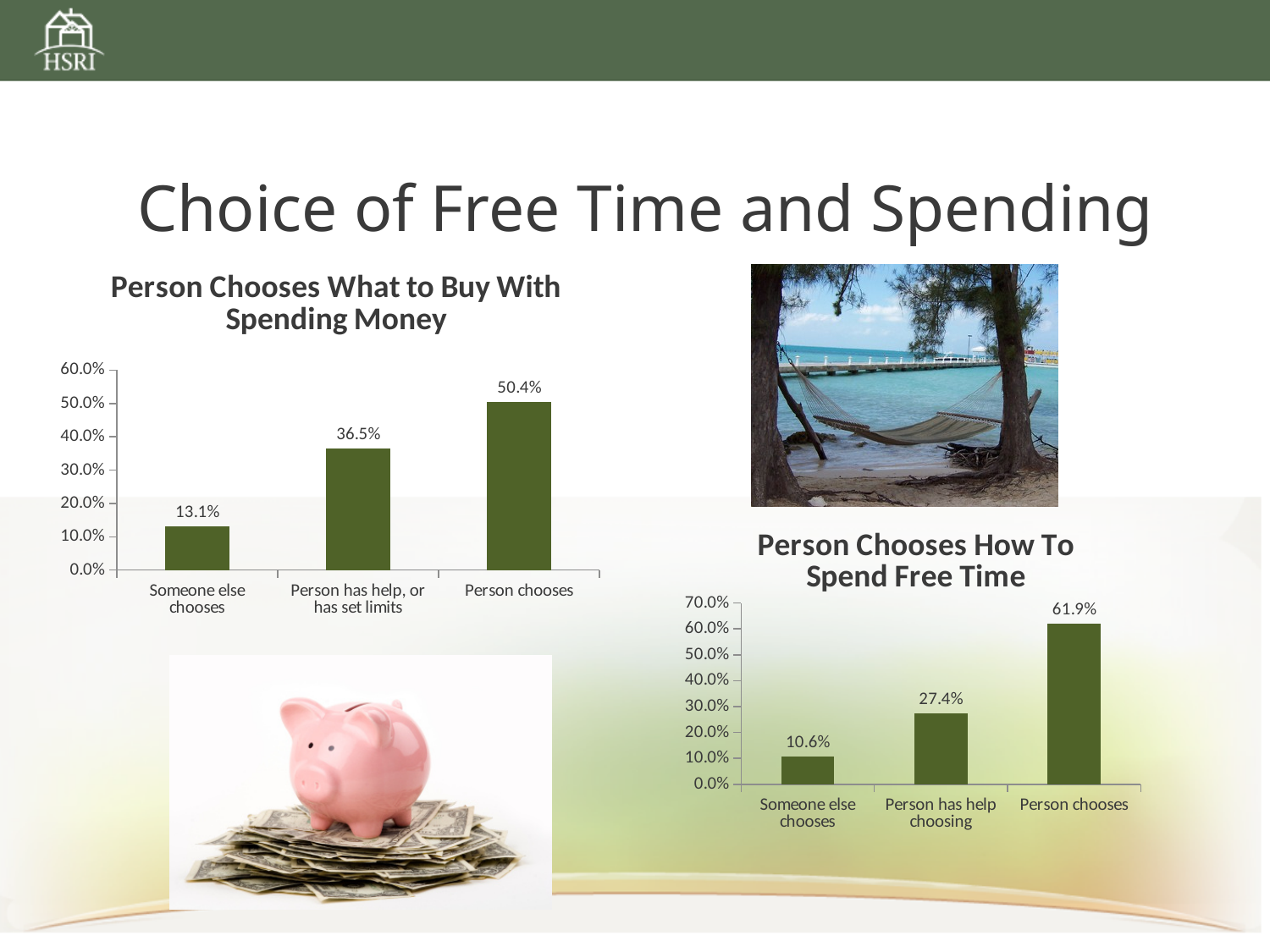
In the 'Person Chooses How To Spend Free Time' chart, what is the value for 'Person has help choosing'? 27.4% What kind of chart is the 'Person Chooses How To Spend Free Time' chart? bar chart In the 'Person Chooses How To Spend Free Time' chart, what is the difference between 'Person chooses' and 'Someone else chooses'? 51.3% In the 'Person Chooses What to Buy With Spending Money' chart, what is the difference between 'Person chooses' and 'Person has help, or has set limits'? 13.9% In the 'Person Chooses How To Spend Free Time' chart, which category has the highest value? Person chooses In the 'Person Chooses What to Buy With Spending Money' chart, which category has the lowest value? Someone else chooses In the 'Person Chooses What to Buy With Spending Money' chart, what is the value for 'Person chooses'? 50.4% Which is larger: 'Person chooses' in the 'Person Chooses How To Spend Free Time' chart or 'Person chooses' in the 'Person Chooses What to Buy With Spending Money' chart? Person Chooses How To Spend Free Time In the 'Person Chooses How To Spend Free Time' chart, do the values rise or fall from left to right along the x axis? rise In the 'Person Chooses What to Buy With Spending Money' chart, what is the value for 'Someone else chooses'? 13.1% How many categories are shown in the 'Person Chooses What to Buy With Spending Money' chart? 3 In the 'Person Chooses How To Spend Free Time' chart, is the value for 'Person has help choosing' greater or less than 30.0%? less